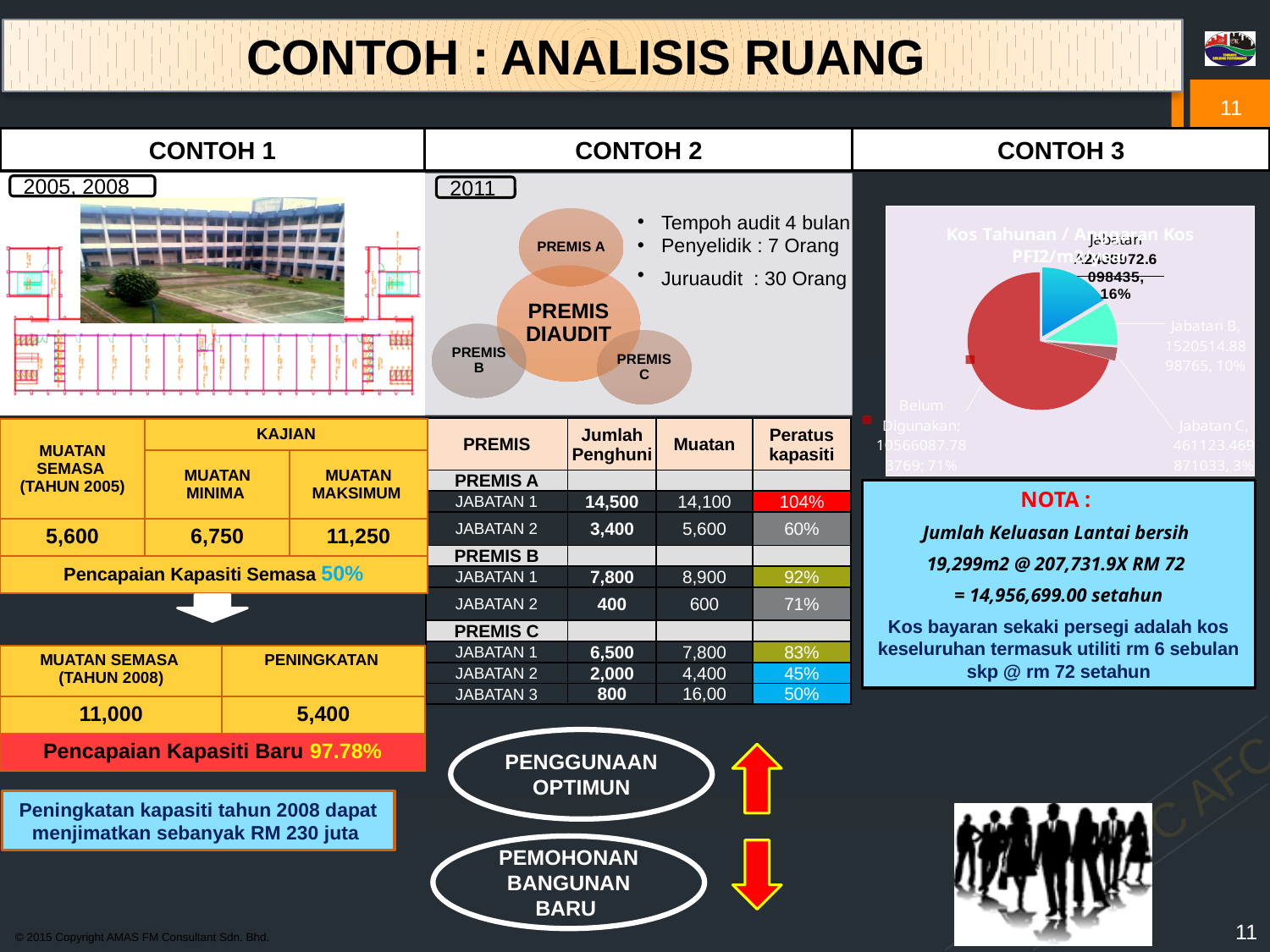
In the CONTOH 3 pie chart, what share is labelled for Jabatan B? 10% Which slice of the CONTOH 3 pie chart is the smallest? Jabatan C In the CONTOH 3 pie chart, what share is labelled for Belum Digunakan? 71% In the CONTOH 3 pie chart, by how many percentage points does the Belum Digunakan share exceed the Jabatan A share? 55 percentage points How many slices does the pie chart in CONTOH 3 have? 4 In the CONTOH 3 pie chart, what share is labelled for Jabatan C? 3% What colour is the largest slice of the CONTOH 3 pie chart? Red What kind of chart is shown in the CONTOH 3 section of the slide? Pie chart Which slice of the CONTOH 3 pie chart is the largest? Belum Digunakan In the CONTOH 3 pie chart, which has the larger share, Jabatan A or Jabatan B? Jabatan A